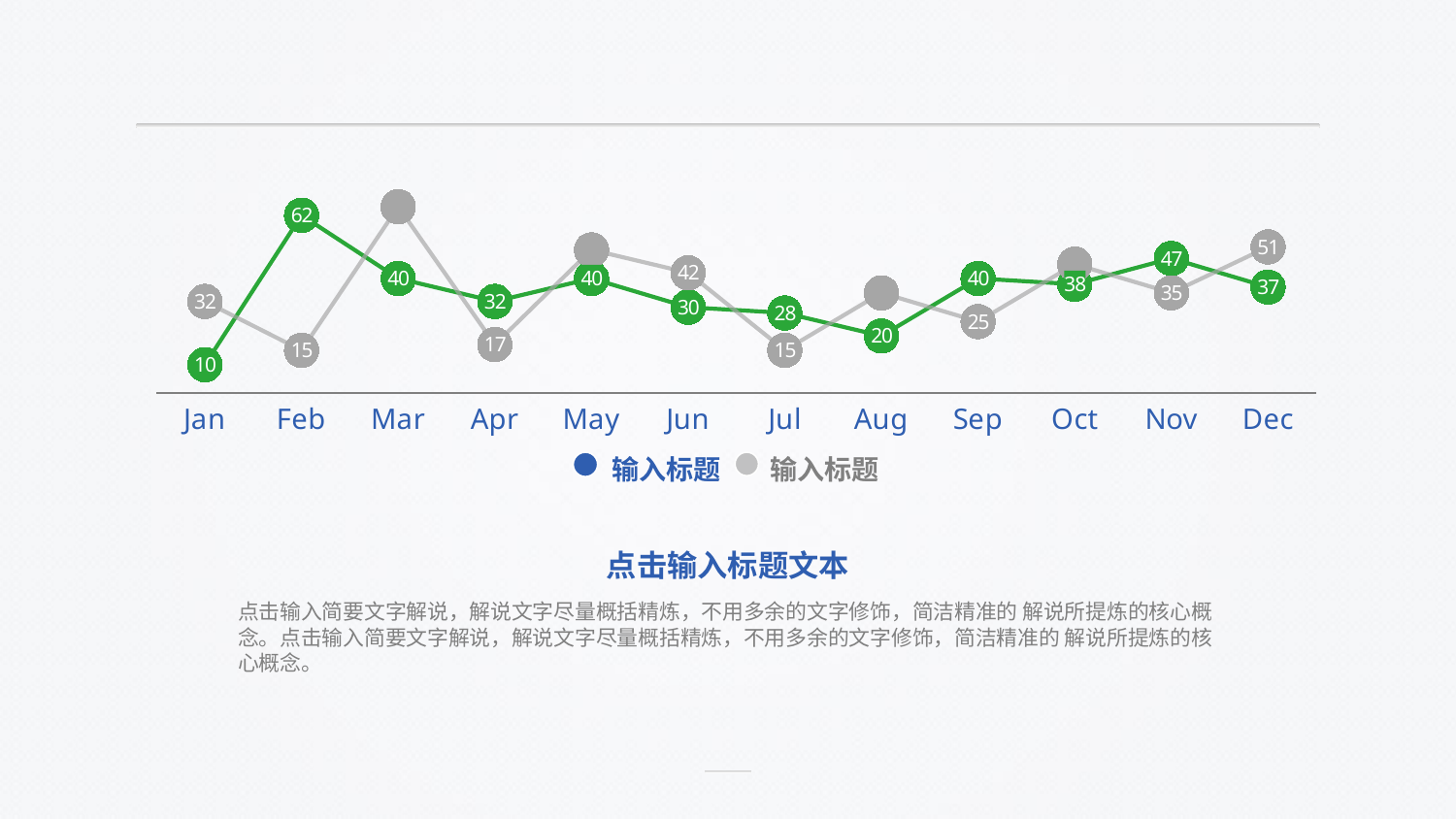
What is the value of the green series in Aug? 20 In which month does the grey series reach its highest point? Mar What is the difference between the green series values in Feb and Jan? 52 In which month does the green series reach its highest value? Feb How many series does the legend list? 2 How many months are plotted along the x axis? 12 Does the green series rise or fall from May to Aug? fall In which month does the green series have its lowest value? Jan What is the value of the grey series in Dec? 51 In Nov, which series has the larger value, green or grey? green What kind of chart is shown on the slide? line chart What is the value of the green series in Feb? 62